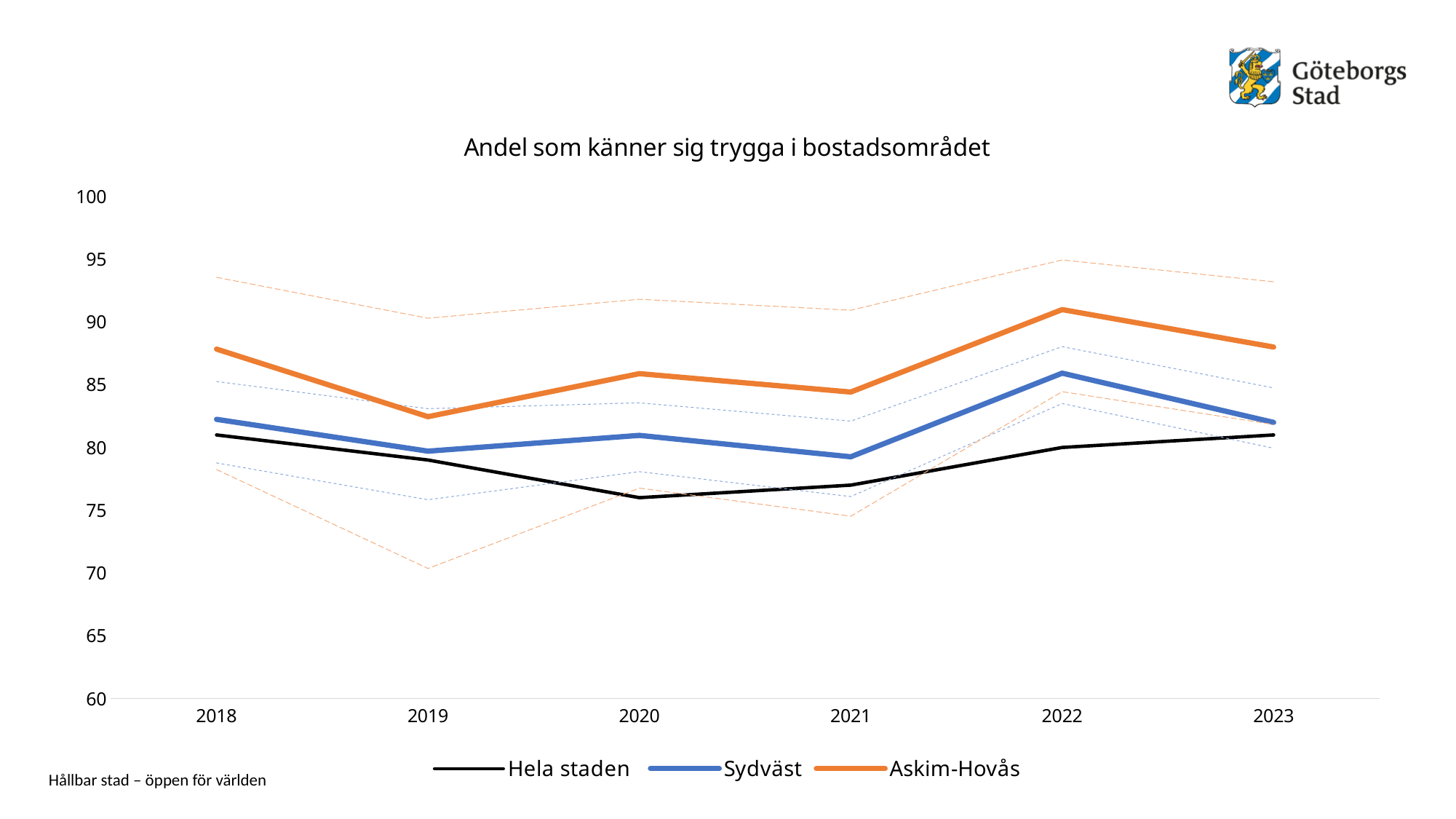
Does the Hela staden line rise or fall from 2020 to 2023? rise Is the value for Sydväst in 2022 greater or less than 80? greater How many series does the legend list? 3 In which year does Askim-Hovås reach its highest value? 2022 Which colour is used for the Askim-Hovås line? orange Is the value for Askim-Hovås in 2022 greater or less than 85? greater In 2022, which is higher: Askim-Hovås or Sydväst? Askim-Hovås What is the title of the chart? Andel som känner sig trygga i bostadsområdet How many years are shown on the x axis? 6 In which year does Hela staden have its lowest value? 2020 What kind of chart is shown on the slide? line chart Is the value for Hela staden in 2020 greater or less than 80? less